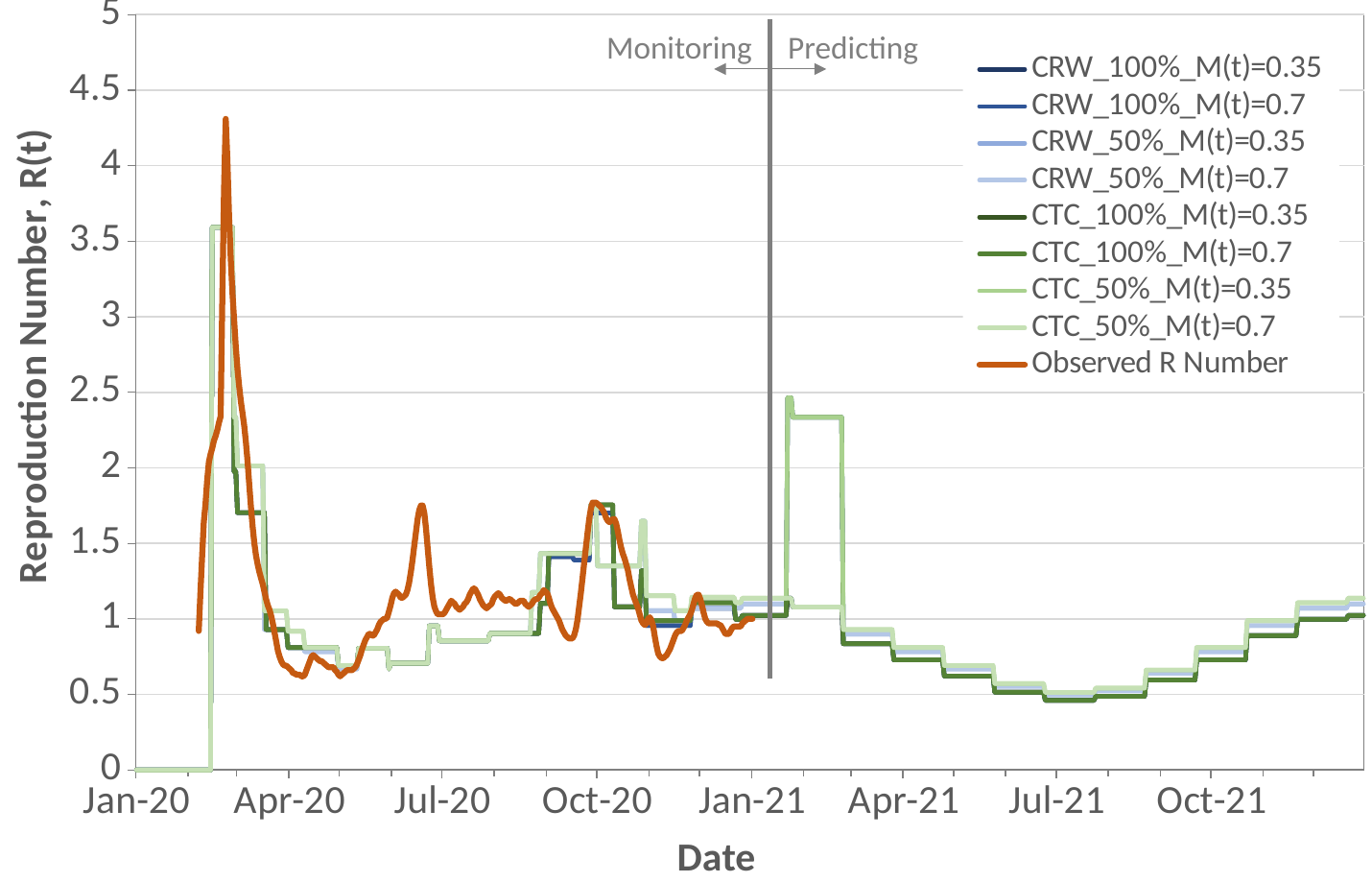
What are the two phases labelled on either side of the vertical grey line? Monitoring and Predicting Is the Observed R Number at its peak near Jul-20 greater or less than 2? less What kind of chart is shown on the slide? line chart From Jul-21 to the end of the chart, do the predicted lines rise or fall? rise Is the Observed R Number at Jan-21 greater or less than 1.5? less How many series does the legend list? 9 In the Predicting period, is the highest value reached by the light green CTC_50% lines greater or less than 2? greater What is the title of the y axis? Reproduction Number, R(t) Which series reaches the highest value on the chart? Observed R Number From its peak in early 2020 to Apr-20, does the Observed R Number rise or fall? fall